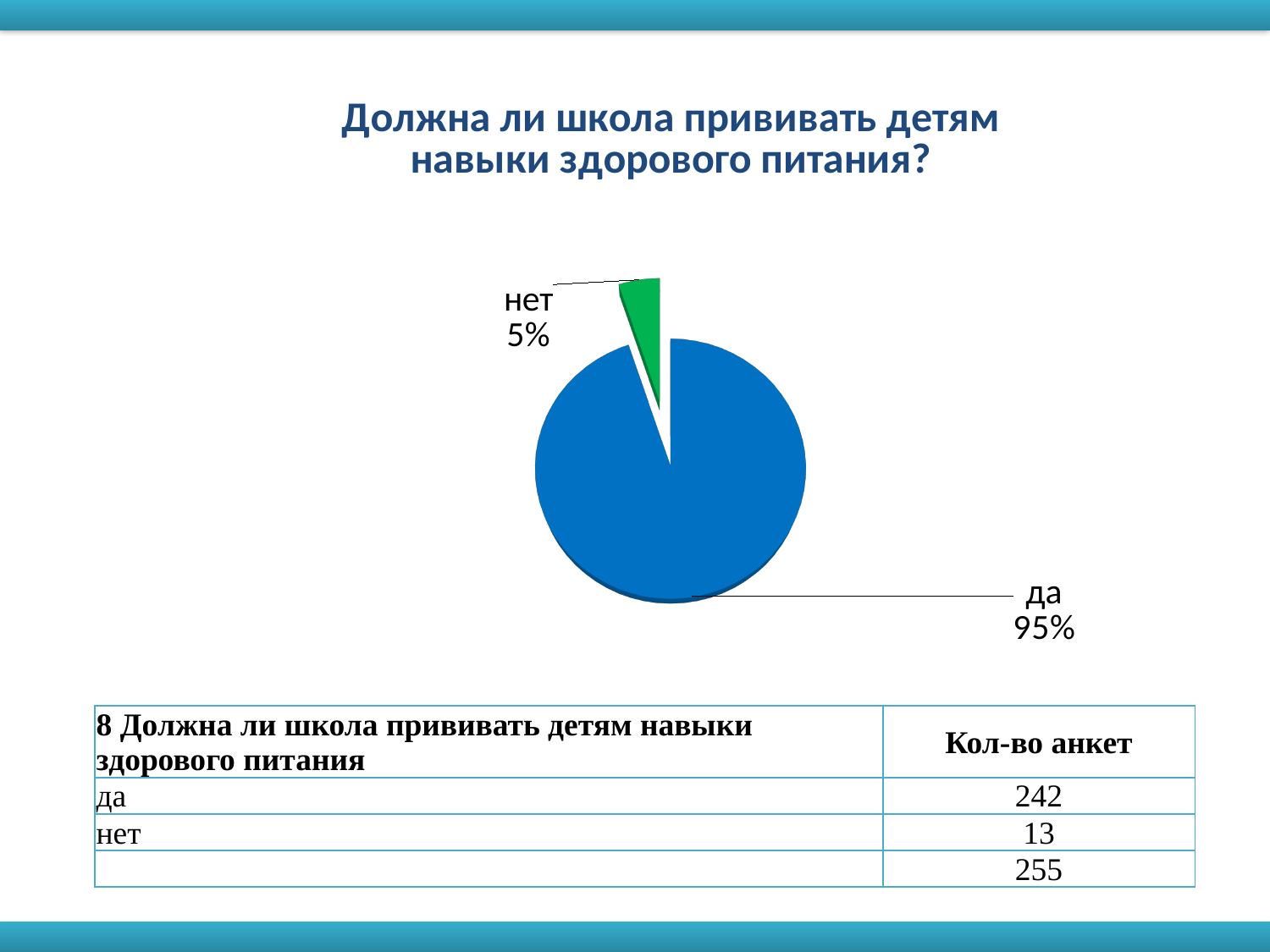
What share of the pie does the "да" slice represent? 95% What is the title of the chart? Должна ли школа прививать детям навыки здорового питания? What colour is the "нет" slice of the pie? green Which slice is larger, "да" or "нет"? да How many slices does the pie chart have? 2 What share of the pie does the "нет" slice represent? 5% Which slice of the pie is the largest? да What kind of chart is shown on the slide? pie chart Which slice of the pie is the smallest? нет What is the difference in percentage points between the "да" and "нет" slices? 90%